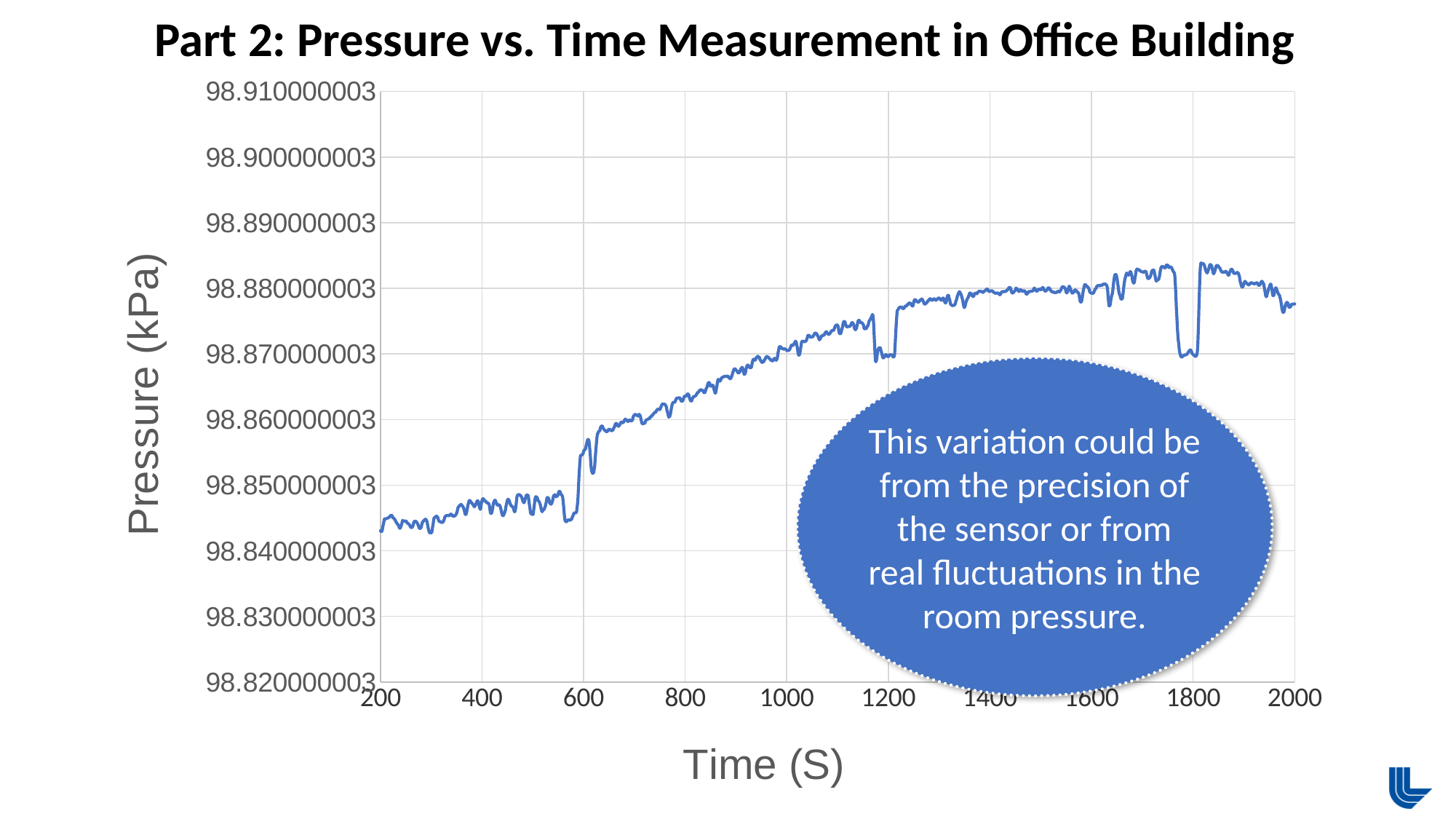
What kind of chart is shown on the slide? line chart Is the pressure at time 1600 greater or less than 98.890000003? less What is the label of the y axis? Pressure (kPa) Which is larger, the pressure at time 800 or the pressure at time 400? time 800 What is the label of the x axis? Time (S) Is the pressure at time 2000 greater or less than 98.870000003? greater Is the pressure at time 400 greater or less than 98.850000003? less Which is larger, the pressure at time 200 or the pressure at time 2000? time 2000 Overall, does the pressure rise or fall as time increases from 200 to 2000 seconds? rise